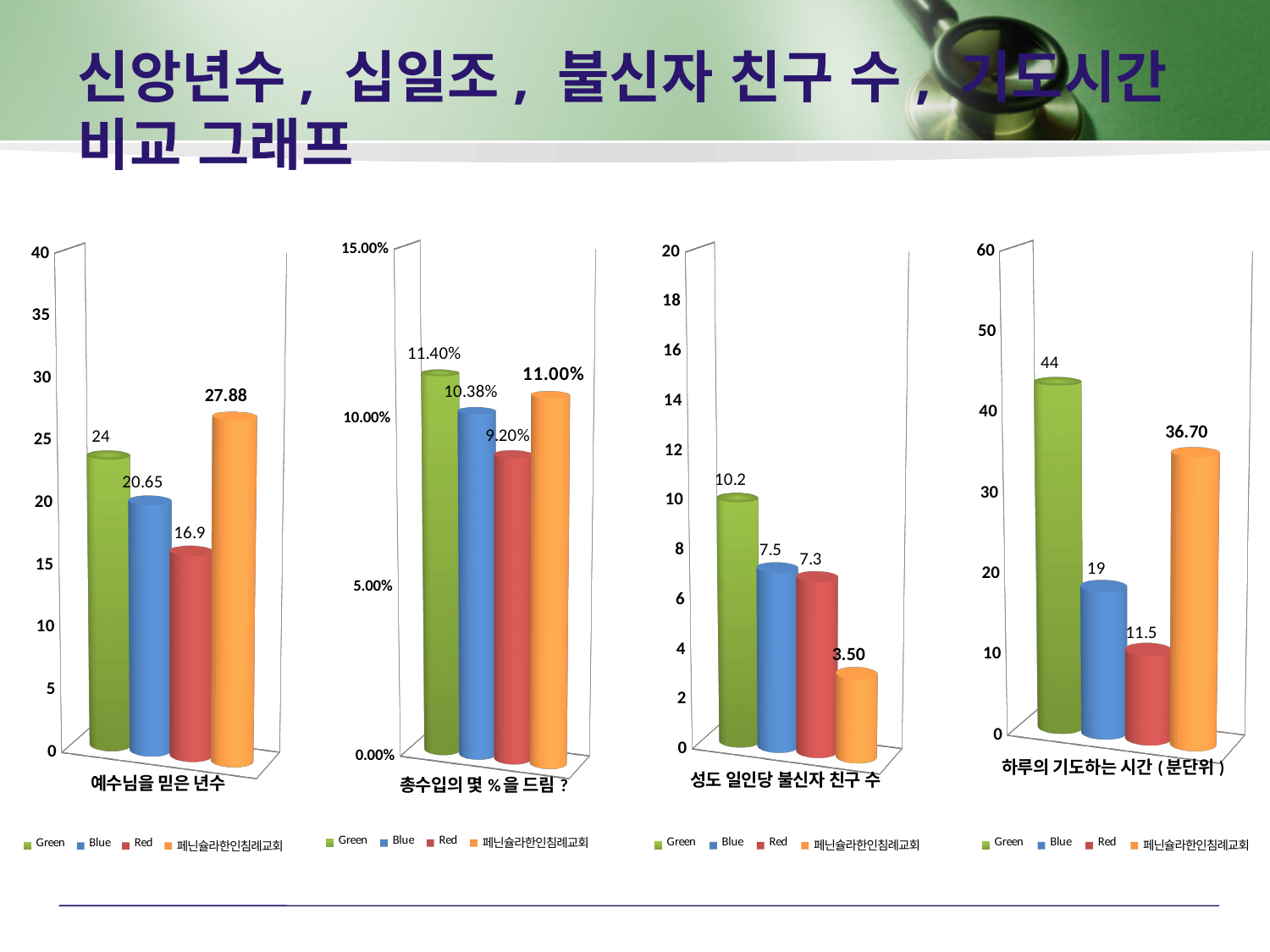
How many series does the legend of the rightmost chart (하루의 기도하는 시간) list? 4 In the rightmost chart (하루의 기도하는 시간), what is the value for the Red series? 11.5 In the second chart from the left (총수입의 몇 %을 드림?), which series has the lowest value? Red In the second chart from the left (총수입의 몇 %을 드림?), what is the value for the Blue series? 10.38% What kind of chart is the leftmost chart (예수님을 믿은 년수)? Bar chart In the leftmost chart (예수님을 믿은 년수), which series has the highest value? 페닌슐라한인침례교회 In the third chart from the left (성도 일인당 불신자 친구 수), what is the value for the 페닌슐라한인침례교회 series? 3.50 In the rightmost chart (하루의 기도하는 시간), what is the difference between the Green value and the 페닌슐라한인침례교회 value? 7.30 In the third chart from the left (성도 일인당 불신자 친구 수), which is larger, the Green value or the Blue value? Green In the leftmost chart (예수님을 믿은 년수), what is the value for the Green series? 24 In the second chart from the left (총수입의 몇 %을 드림?), is the Green value greater or less than 10.00%? greater In the leftmost chart (예수님을 믿은 년수), what is the difference between the 페닌슐라한인침례교회 value and the Red value? 10.98